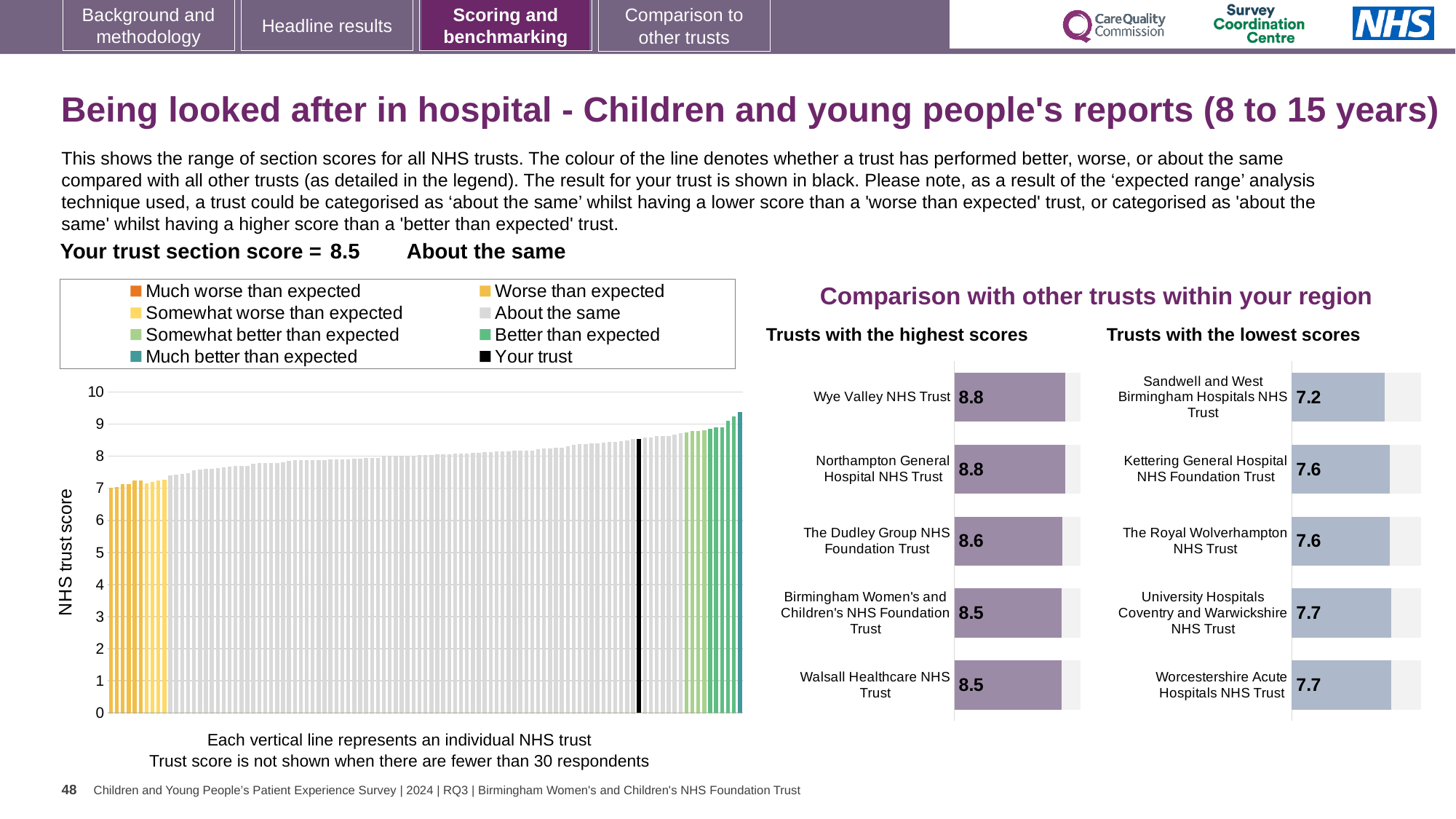
What kind of chart is the large chart on the left showing NHS trust scores? bar chart In the 'Trusts with the lowest scores' chart, which has the larger score: Kettering General Hospital NHS Foundation Trust or University Hospitals Coventry and Warwickshire NHS Trust? University Hospitals Coventry and Warwickshire NHS Trust In the 'Trusts with the highest scores' chart, what is the difference between the score for Wye Valley NHS Trust and The Dudley Group NHS Foundation Trust? 0.2 How many trusts are shown in the 'Trusts with the highest scores' chart? 5 In the large chart on the left, do the trust scores rise or fall from left to right? rise In the 'Trusts with the lowest scores' chart, what is the difference between the score for Worcestershire Acute Hospitals NHS Trust and Sandwell and West Birmingham Hospitals NHS Trust? 0.5 How many entries does the legend above the large chart on the left list? 8 In the large chart on the left, is the value of the rightmost (highest) bar greater or less than 9? greater In the large chart on the left, is the value of the leftmost (lowest) bar greater or less than 6? greater In the large chart on the left, what colour is the bar for your trust? black In the 'Trusts with the lowest scores' chart, which trust has the lowest score? Sandwell and West Birmingham Hospitals NHS Trust In the 'Trusts with the highest scores' chart, what is the score for The Dudley Group NHS Foundation Trust? 8.6